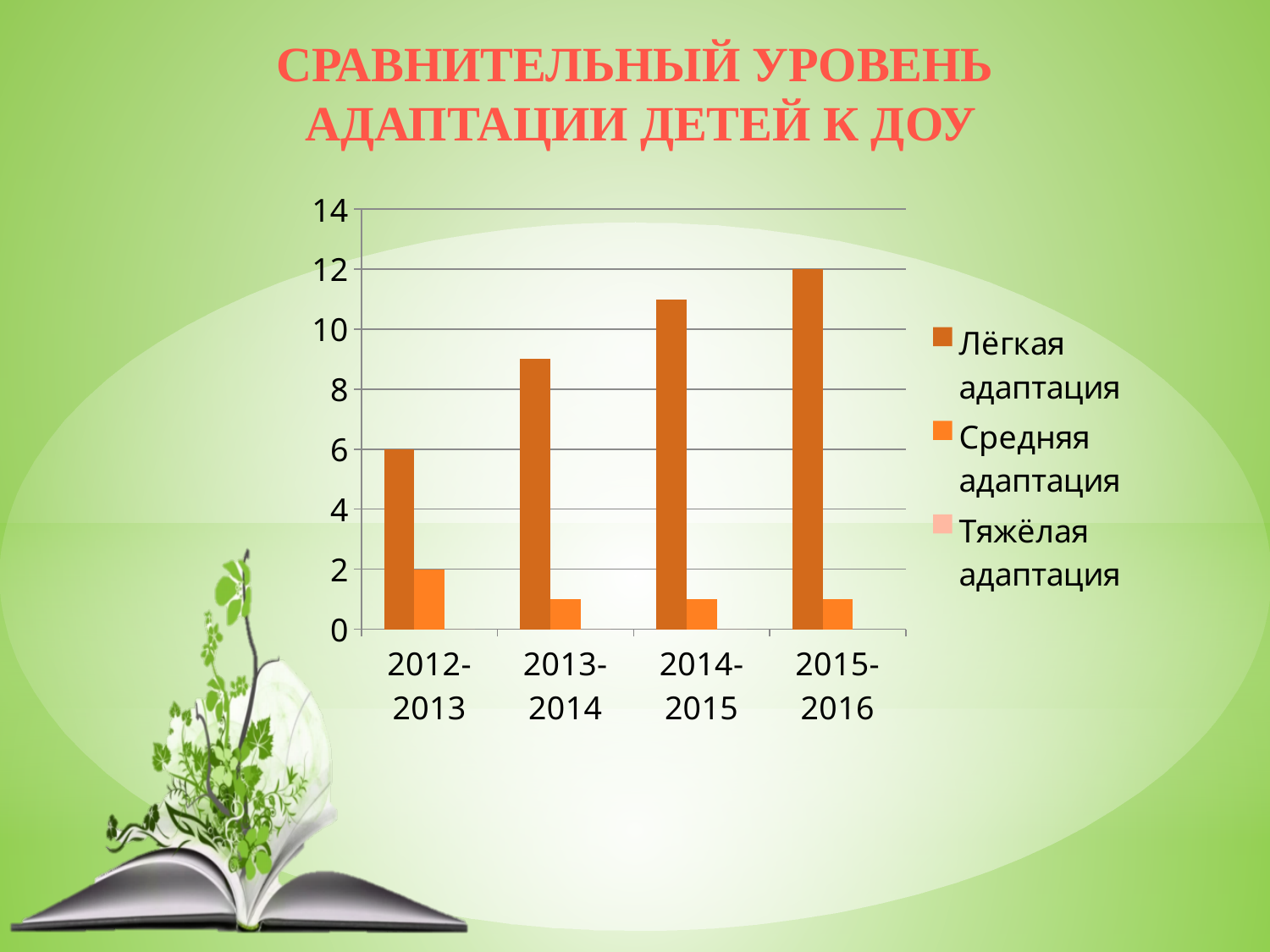
What is the value of Лёгкая адаптация for 2015-2016? 12 In which year is Лёгкая адаптация highest? 2015-2016 How many series does the legend list? 3 What is the value of Лёгкая адаптация for 2012-2013? 6 What is the value of Средняя адаптация for 2012-2013? 2 What is the title of the chart on the slide? СРАВНИТЕЛЬНЫЙ УРОВЕНЬ АДАПТАЦИИ ДЕТЕЙ К ДОУ What kind of chart is shown on the slide? bar chart What is the difference between Лёгкая адаптация in 2015-2016 and in 2012-2013? 6 Does Лёгкая адаптация rise or fall from 2012-2013 to 2015-2016? rise In which year is Лёгкая адаптация lowest? 2012-2013 Is the value of Лёгкая адаптация for 2013-2014 greater or less than 8? greater How many year categories are shown on the x axis? 4